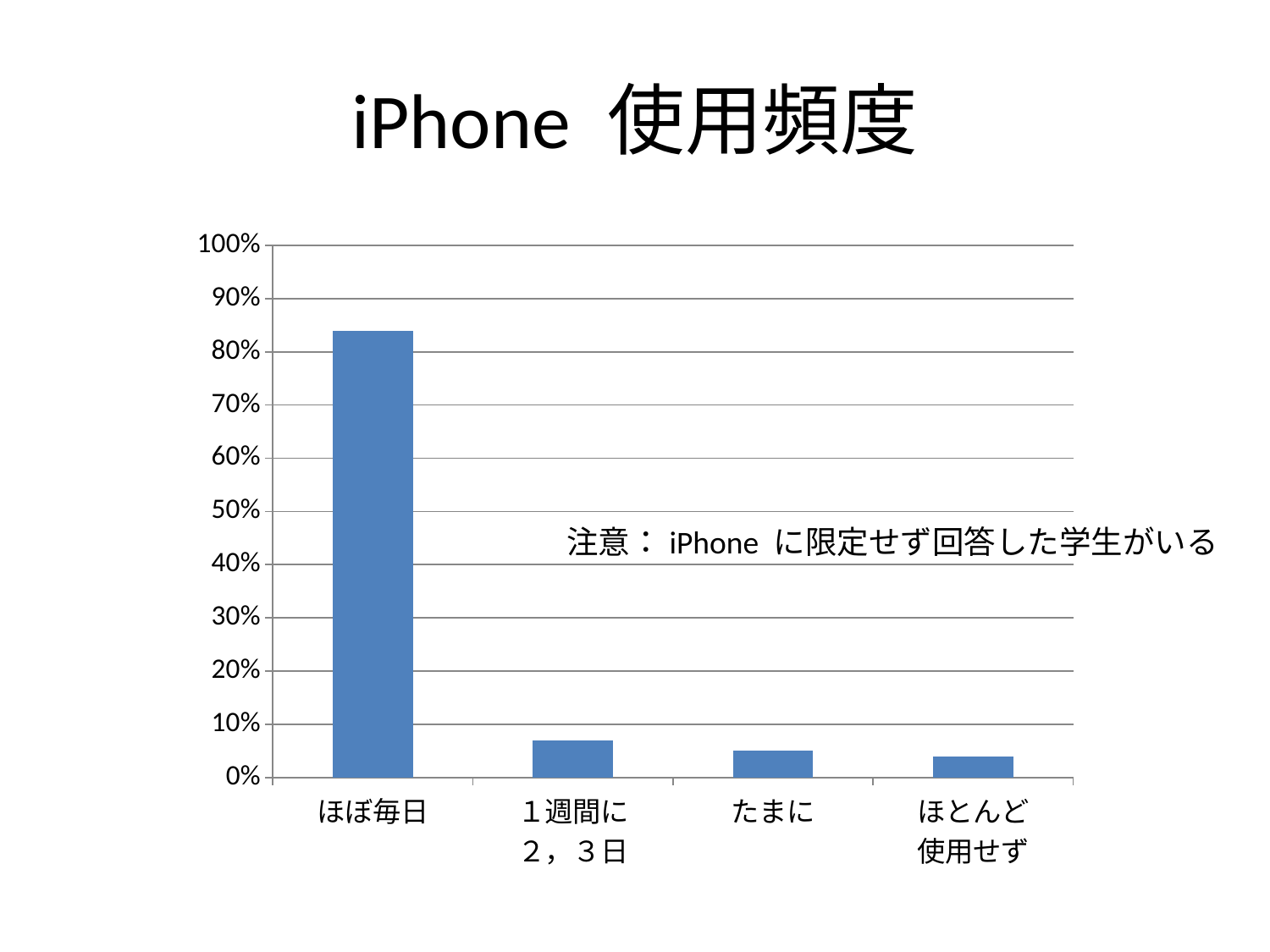
Is the value for ほぼ毎日 greater or less than 90%? less Is the value for 1週間に2，3日 greater or less than 10%? less Which is larger, the value for 1週間に2，3日 or the value for ほとんど使用せず? 1週間に2，3日 Which category has the highest value? ほぼ毎日 How many categories are shown on the x axis? 4 Which is larger, the value for ほぼ毎日 or the value for 1週間に2，3日? ほぼ毎日 What is the maximum value shown on the y axis? 100% What is the title of the chart? iPhone 使用頻度 What kind of chart is shown on the slide? bar chart Is the value for ほぼ毎日 greater or less than 80%? greater Do the values rise or fall from left to right along the x axis? fall